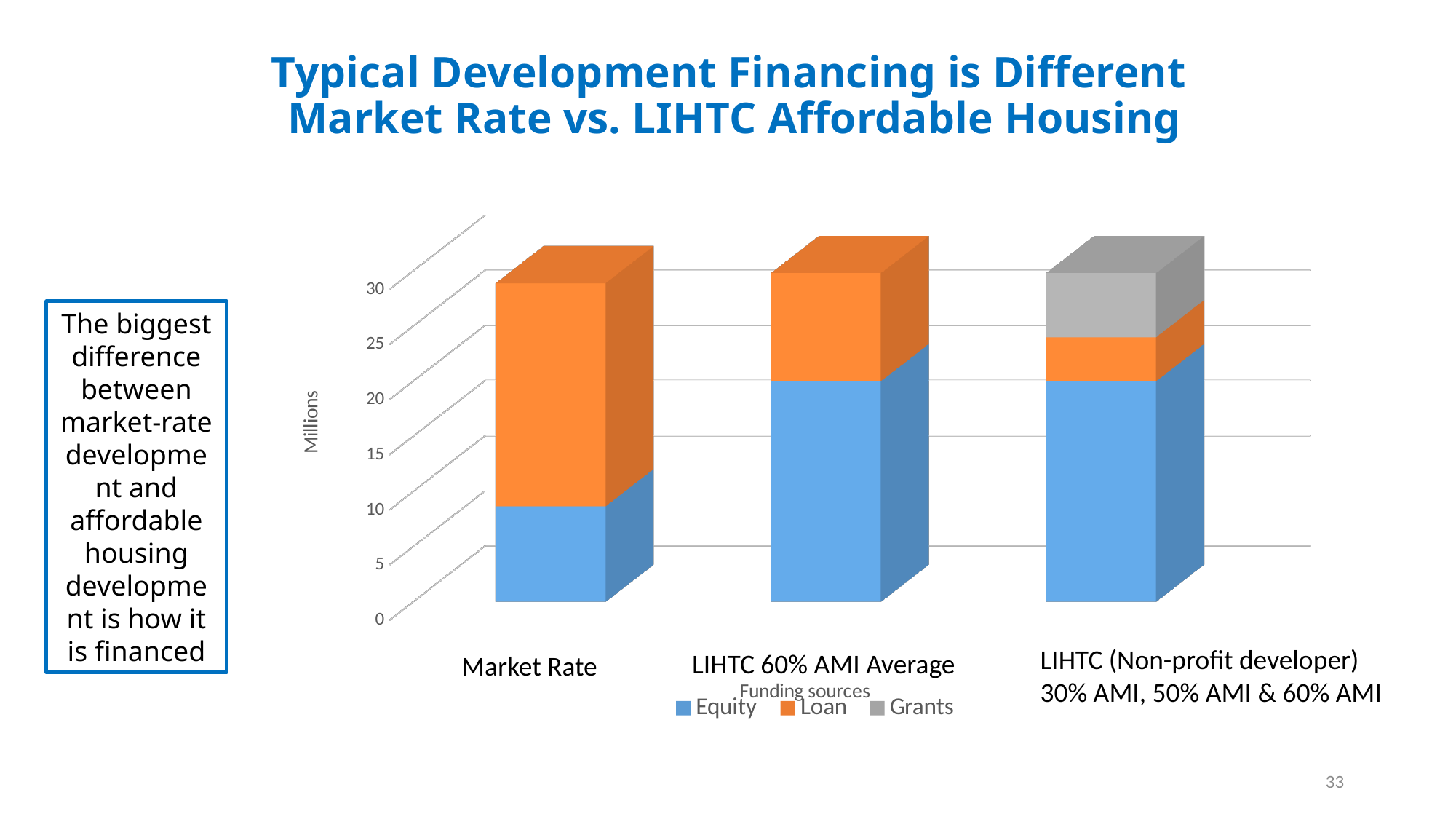
Which is larger, the Equity value for Market Rate or the Equity value for LIHTC 60% AMI Average? LIHTC 60% AMI Average How many series does the chart's legend list? 3 Is the Equity value for LIHTC 60% AMI Average greater or less than 15? greater Is the Grants value for LIHTC (Non-profit developer) greater or less than 10? less Which category is the only one with a Grants segment? LIHTC (Non-profit developer) 30% AMI, 50% AMI & 60% AMI What is the label on the vertical axis of the chart? Millions What kind of chart is shown on the slide? Stacked bar chart Is the Equity value for Market Rate greater or less than 15? less Which category has the smallest Loan segment? LIHTC (Non-profit developer) 30% AMI, 50% AMI & 60% AMI How many categories are shown on the x axis of the chart? 3 Which category has the largest Loan segment? Market Rate Which category has the smallest Equity segment? Market Rate